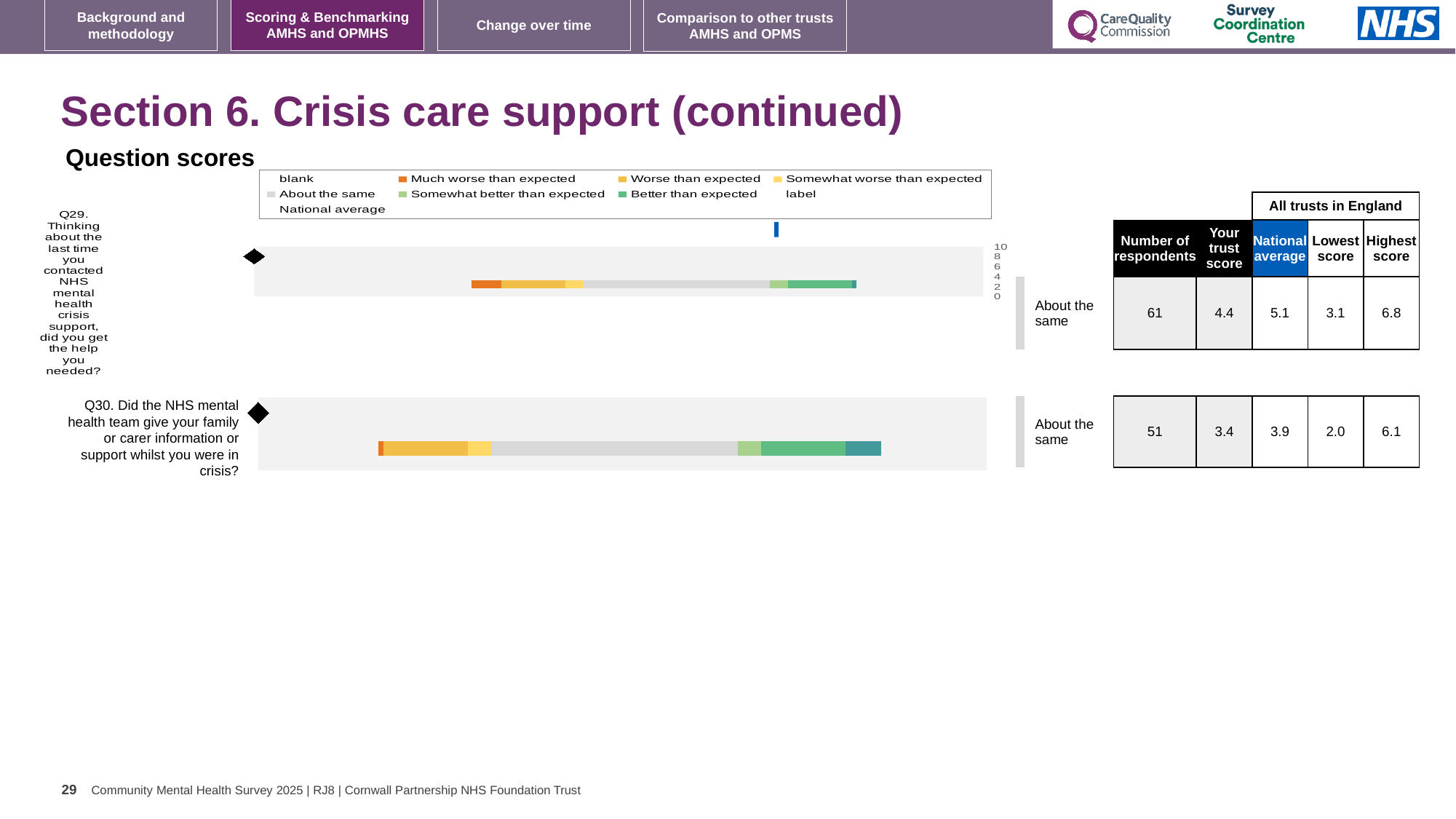
How many questions (bars) are plotted in the question scores chart? 2 What benchmark category is shown next to the bar for Q29? About the same What is the trust score for Q30 in the table beside the chart? 3.4 Which question has the higher trust score, Q29 or Q30? Q29 How many respondents answered Q30? 51 What is the highest score across all trusts in England for Q30? 6.1 What is the trust score for Q29 in the table beside the chart? 4.4 What is the difference between the national average and the trust score for Q29? 0.7 What kind of chart is used to show the question scores for Q29 and Q30? bar chart What benchmark category is shown next to the bar for Q30? About the same What is the national average for Q29? 5.1 Which legend entry is shown in orange in the question scores chart? Much worse than expected